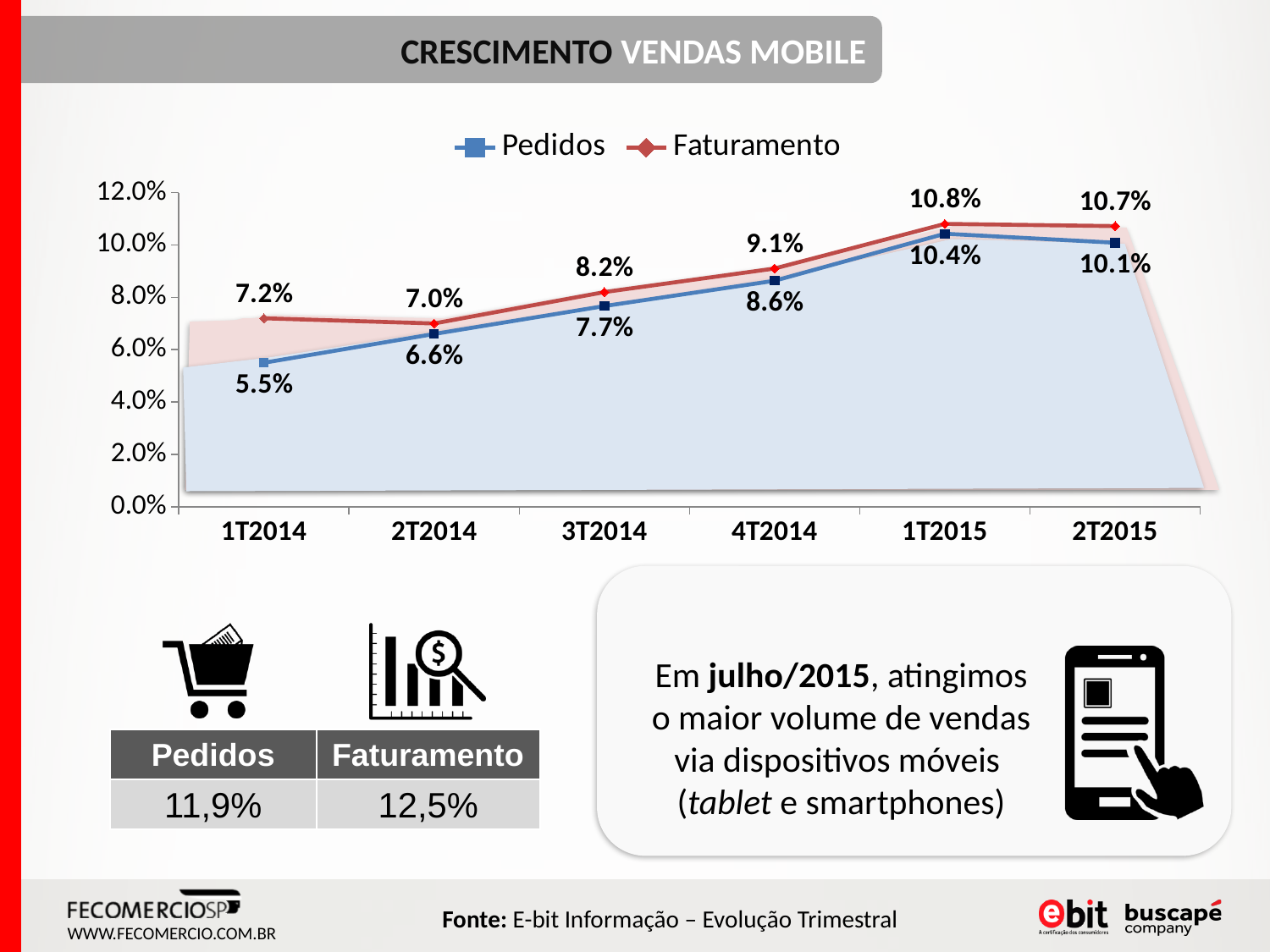
What is the value of Pedidos in 1T2014? 5.5% Is the value of Pedidos in 1T2015 greater or less than 10.0%? greater What is the value of Faturamento in 4T2014? 9.1% In which quarter is Faturamento highest? 1T2015 What is the difference between Faturamento and Pedidos in 1T2014? 1.7% How many quarters are shown on the x axis? 6 What kind of chart is shown on the slide? line chart Does Pedidos rise or fall from 1T2014 to 1T2015? rise What is the value of Pedidos in 2T2015? 10.1% Which is larger in 3T2014, Pedidos or Faturamento? Faturamento In which quarter is Pedidos lowest? 1T2014 How many series does the legend list? 2